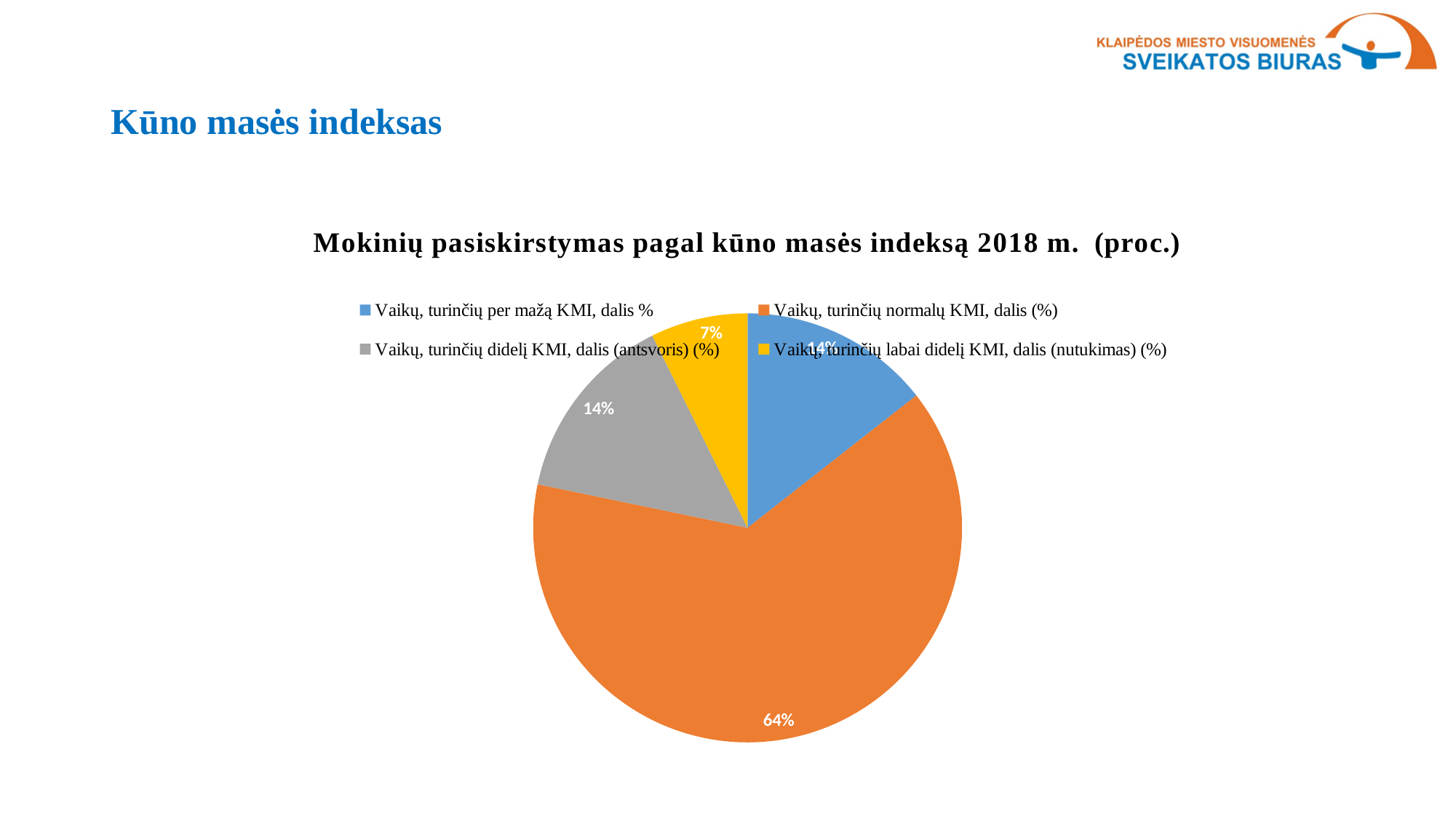
What is the title of the chart? Mokinių pasiskirstymas pagal kūno masės indeksą 2018 m. (proc.) By how many percentage points does the normal BMI share (64%) exceed the overweight (antsvoris) share (14%)? 50 percentage points Which category has the largest slice of the pie? Vaikų, turinčių normalų KMI, dalis (%) Which is larger: the share of pupils with normal BMI or the share with obesity (nutukimas)? normal BMI (normalų KMI) What kind of chart is shown on the slide? pie chart What colour is the slice for Vaikų, turinčių normalų KMI? orange How many slices does the pie chart have? 4 What percentage is shown for Vaikų, turinčių didelį KMI, dalis (antsvoris)? 14% What percentage is shown for Vaikų, turinčių labai didelį KMI, dalis (nutukimas)? 7% What percentage of pupils had a normal BMI (Vaikų, turinčių normalų KMI) in 2018? 64% What is the difference between the overweight (antsvoris) share and the obesity (nutukimas) share? 7 percentage points Which category has the smallest slice of the pie? Vaikų, turinčių labai didelį KMI, dalis (nutukimas) (%)